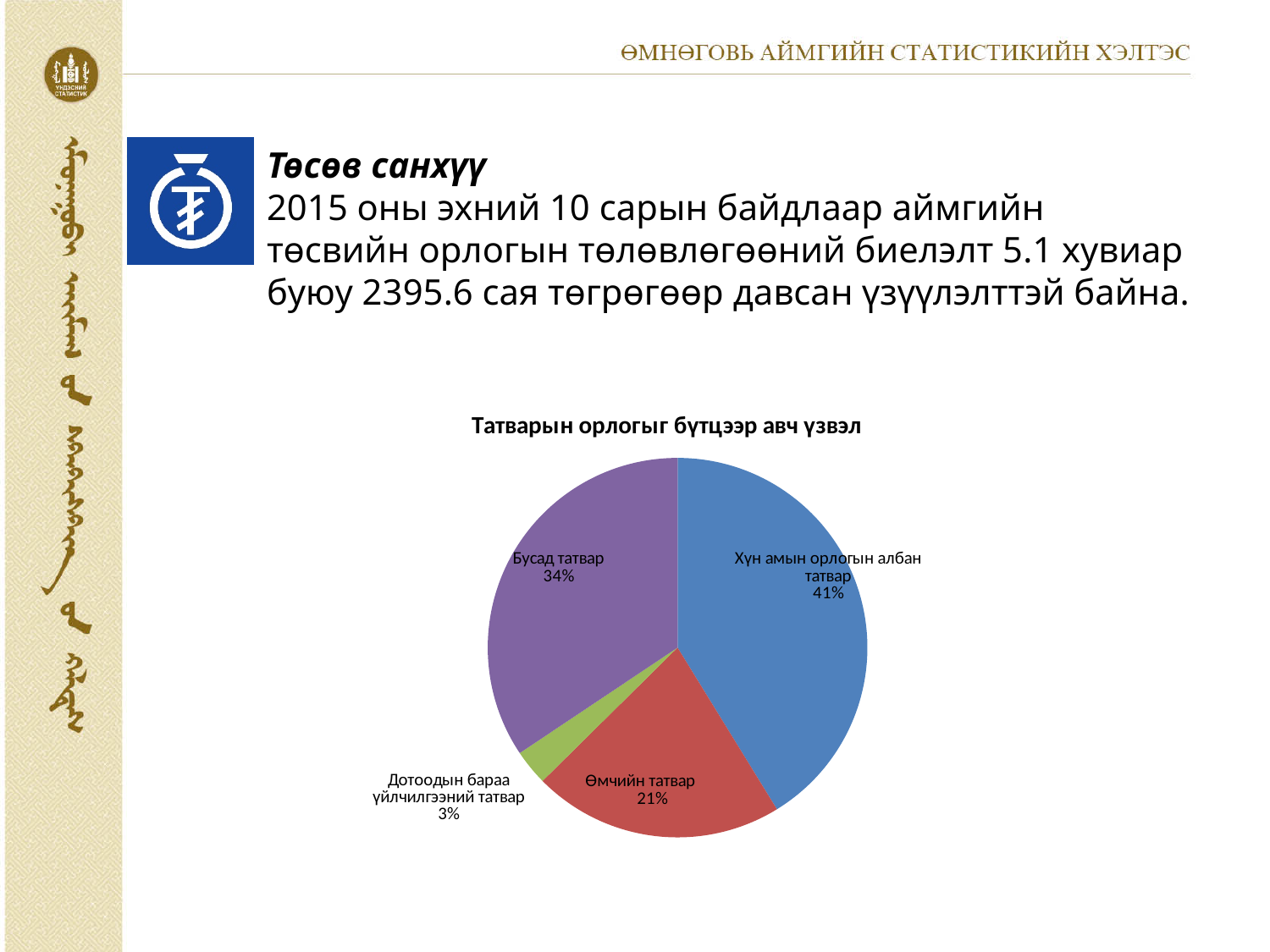
What share of the pie does Бусад татвар have? 34% What share of the pie does Өмчийн татвар have? 21% Which is larger, the share for Бусад татвар or the share for Өмчийн татвар? Бусад татвар What share of the pie does Хүн амын орлогын албан татвар have? 41% Which category has the largest slice of the pie? Хүн амын орлогын албан татвар What is the title of the chart? Татварын орлогыг бүтцээр авч үзвэл Which category has the smallest slice of the pie? Дотоодын бараа үйлчилгээний татвар What is the difference in percentage points between Хүн амын орлогын албан татвар and Өмчийн татвар? 20 How many slices does the pie chart have? 4 What kind of chart is shown on the slide? pie chart What colour is the slice for Өмчийн татвар? red